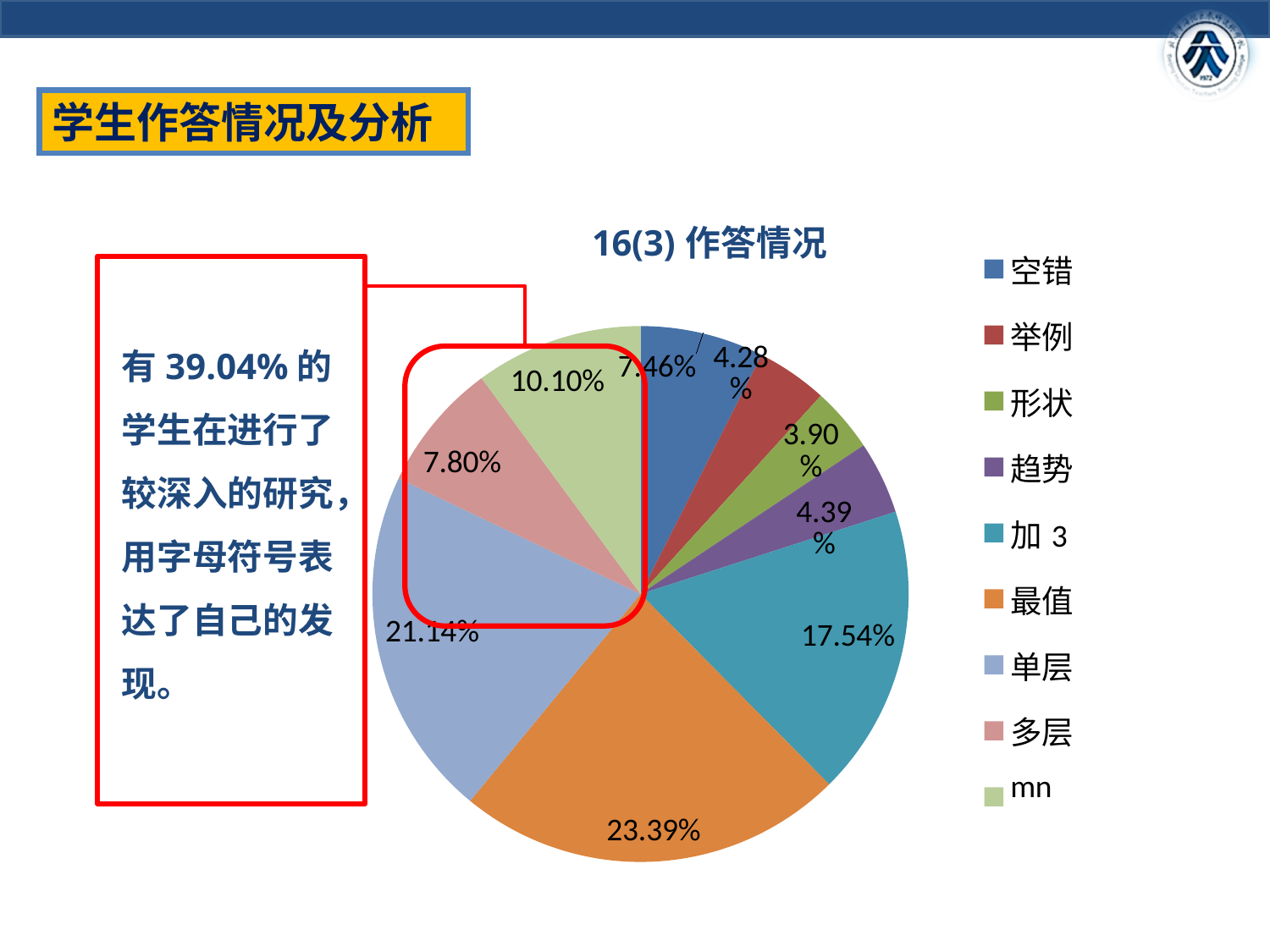
What percentage does the 加 3 slice show? 17.54% What is the difference between the 最值 share and the 单层 share? 2.25% What is the title of the pie chart? 16(3) 作答情况 Which is larger, the share for 单层 or the share for 加 3? 单层 What percentage does the 最值 slice show? 23.39% What type of chart is shown on the slide? pie chart Which legend entry is shown in orange? 最值 Which category has the smallest share of the pie? 形状 What percentage does the 单层 slice show? 21.14% How many slices does the pie chart have? 9 Which category has the largest share of the pie? 最值 What percentage does the mn slice show? 10.10%